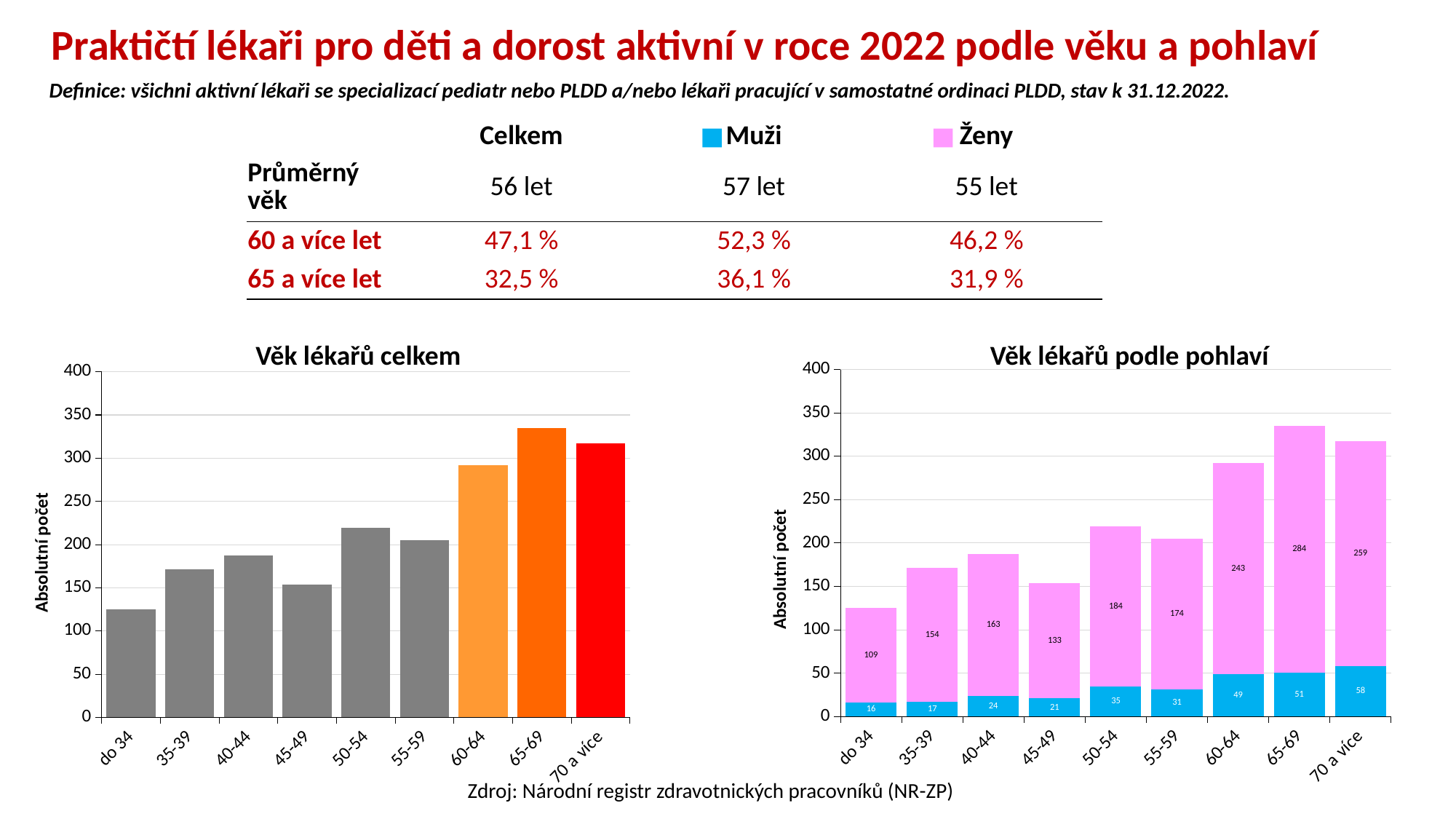
In the chart 'Věk lékařů celkem', is the value for 50-54 greater or less than 200? greater In the chart 'Věk lékařů celkem', which age category has the highest bar? 65-69 How many age categories are shown on the x axis of the chart 'Věk lékařů celkem'? 9 In the chart 'Věk lékařů podle pohlaví', what is the total of the stacked bar for 50-54? 219 In the chart 'Věk lékařů podle pohlaví', which age category has the lowest value for Muži? do 34 In the chart 'Věk lékařů podle pohlaví', which age category has the highest value for Ženy? 65-69 In the chart 'Věk lékařů podle pohlaví', what is the value for Ženy in the 65-69 category? 284 In the chart 'Věk lékařů podle pohlaví', what is the value for Muži in the 70 a více category? 58 In the chart 'Věk lékařů podle pohlaví', is the Muži value for 45-49 larger or smaller than the Muži value for 40-44? smaller What type of chart is 'Věk lékařů podle pohlaví'? stacked bar chart In the chart 'Věk lékařů podle pohlaví', what is the value for Ženy in the do 34 category? 109 In the chart 'Věk lékařů podle pohlaví', what is the difference between the Ženy values for 60-64 and 55-59? 69